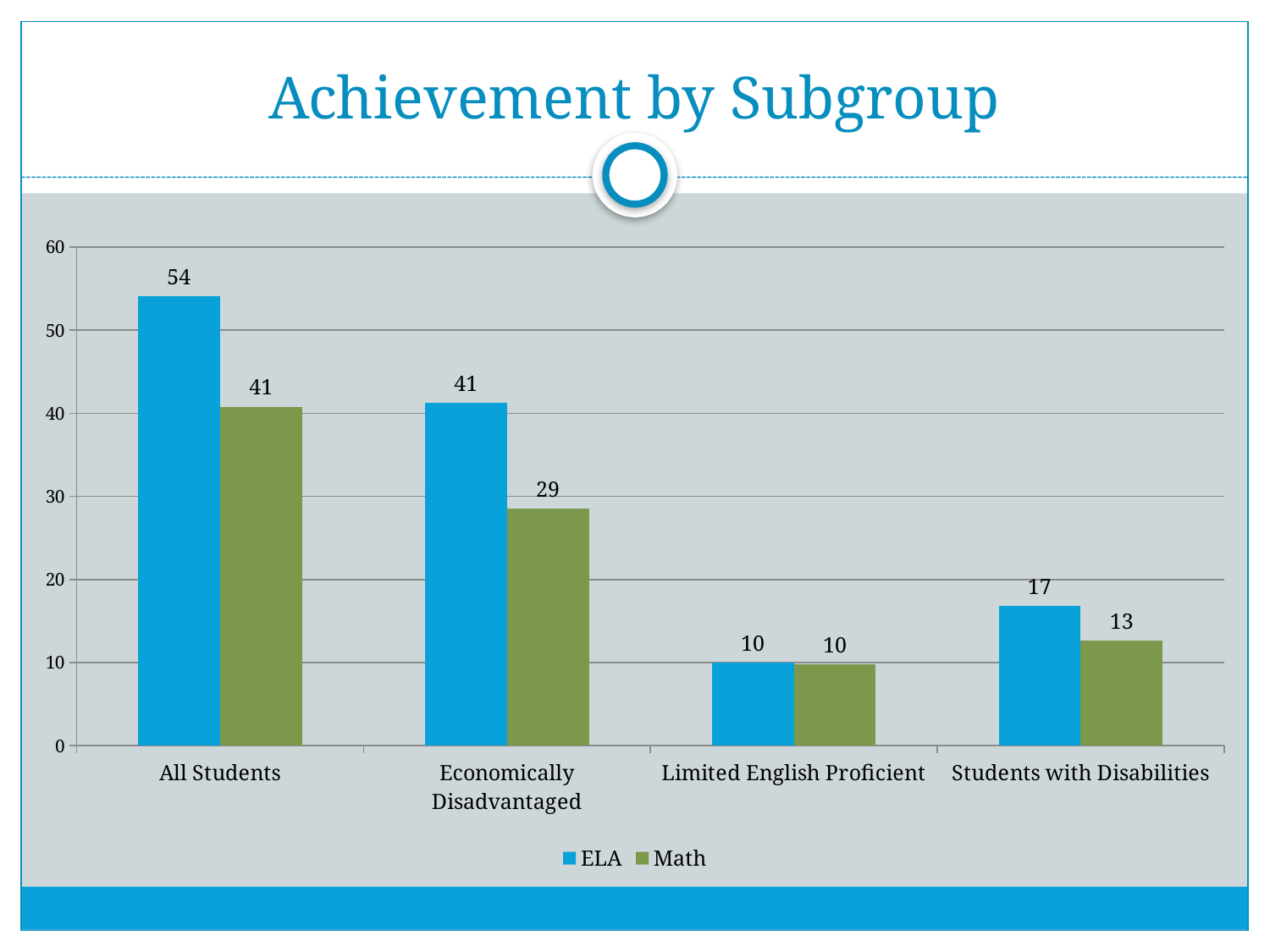
Which subgroup has the lowest Math value? Limited English Proficient How many series does the legend list? 2 What is the ELA value for All Students? 54 Do the ELA values rise or fall from All Students to Limited English Proficient? Fall How many subgroups are shown on the x axis? 4 What is the Math value for Economically Disadvantaged? 29 What kind of chart is shown on the slide? Bar chart What is the title of the chart? Achievement by Subgroup Which is larger for Economically Disadvantaged, the ELA value or the Math value? ELA Which subgroup has the highest ELA value? All Students What is the difference between the ELA and Math values for All Students? 13 What is the ELA value for Students with Disabilities? 17